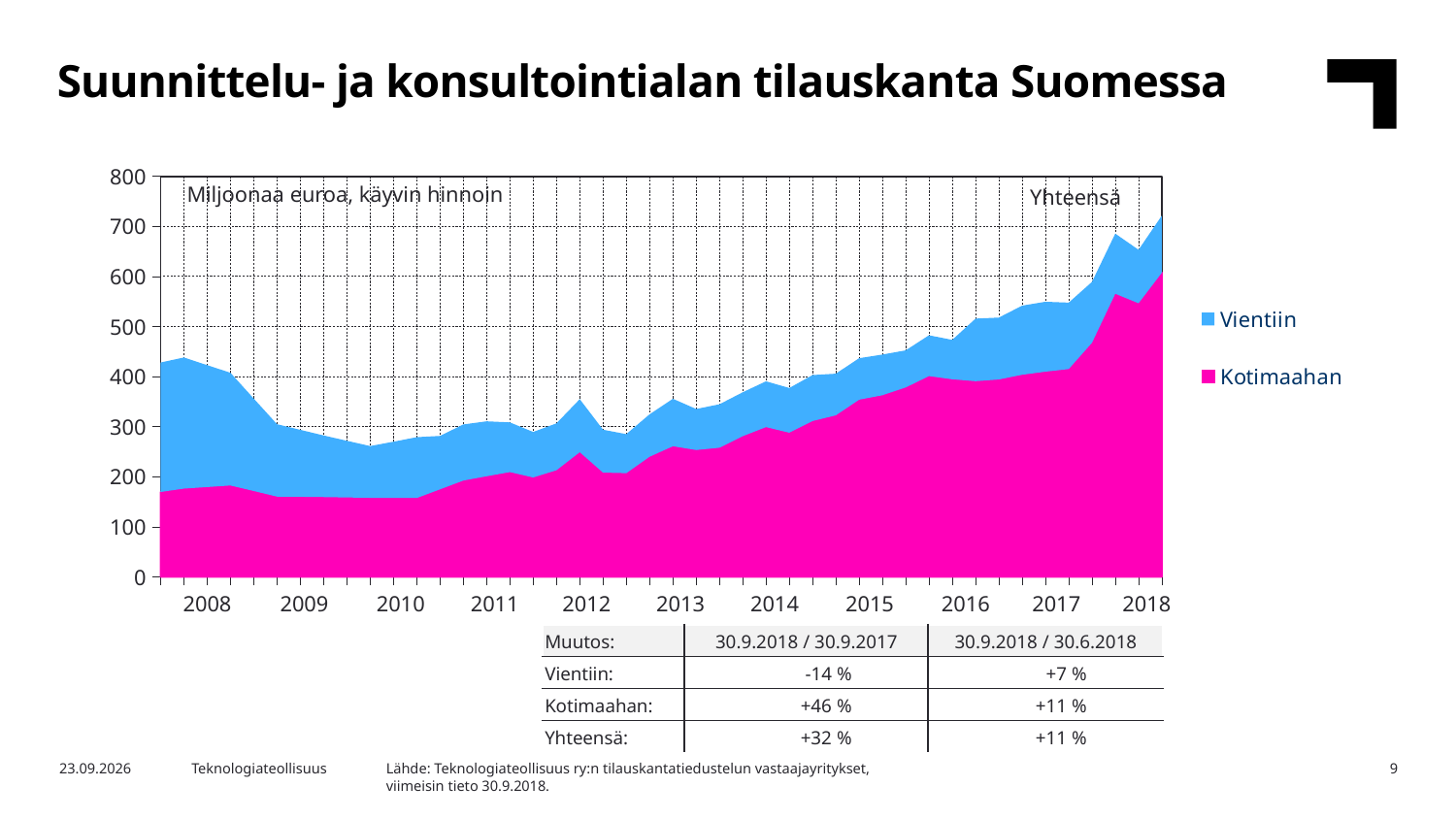
Is the Kotimaahan value at the start of 2008 greater or less than 200? less Does the total order backlog (Yhteensä) rise or fall from 2012 to 2018? Rise Is the total value in 2014 greater or less than 500? less How many year labels are shown on the x axis? 11 What kind of chart is shown on the slide? Stacked area chart Is the Kotimaahan value larger in 2018 or in 2008? 2018 What unit is stated in the chart for the values? Miljoonaa euroa, käyvin hinnoin Is the total value at the start of 2008 greater or less than 400? greater Does the total order backlog rise or fall from 2008 to 2010? Fall Which two series are listed in the chart legend? Vientiin and Kotimaahan In which year does the total order backlog reach its highest level? 2018 How many series does the chart legend list? 2